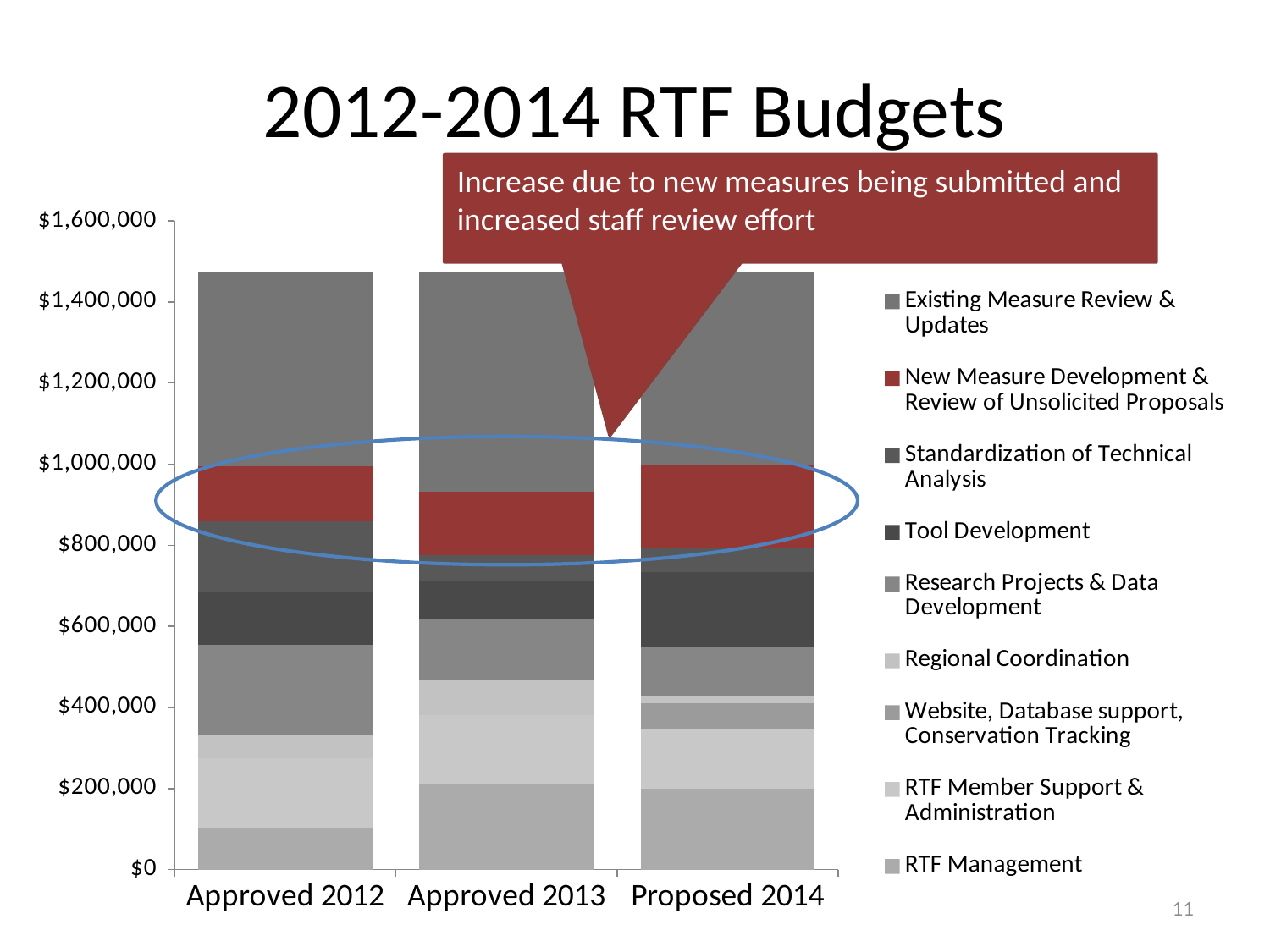
What is the title of the chart? 2012-2014 RTF Budgets Which has a larger New Measure Development & Review of Unsolicited Proposals segment, Approved 2012 or Proposed 2014? Proposed 2014 Is the RTF Management value for Approved 2012 greater or less than $200,000? less Is the total budget for Approved 2012 greater or less than $1,400,000? greater How many budget years (categories) are shown on the x axis? 3 Which has a larger RTF Management segment, Approved 2012 or Approved 2013? Approved 2013 Which has a larger Tool Development segment, Approved 2013 or Proposed 2014? Proposed 2014 What kind of chart is shown on the slide? Stacked bar chart How many series does the legend list? 9 Is the total budget for Proposed 2014 greater or less than $1,600,000? less Which series is shown in red in the chart? New Measure Development & Review of Unsolicited Proposals